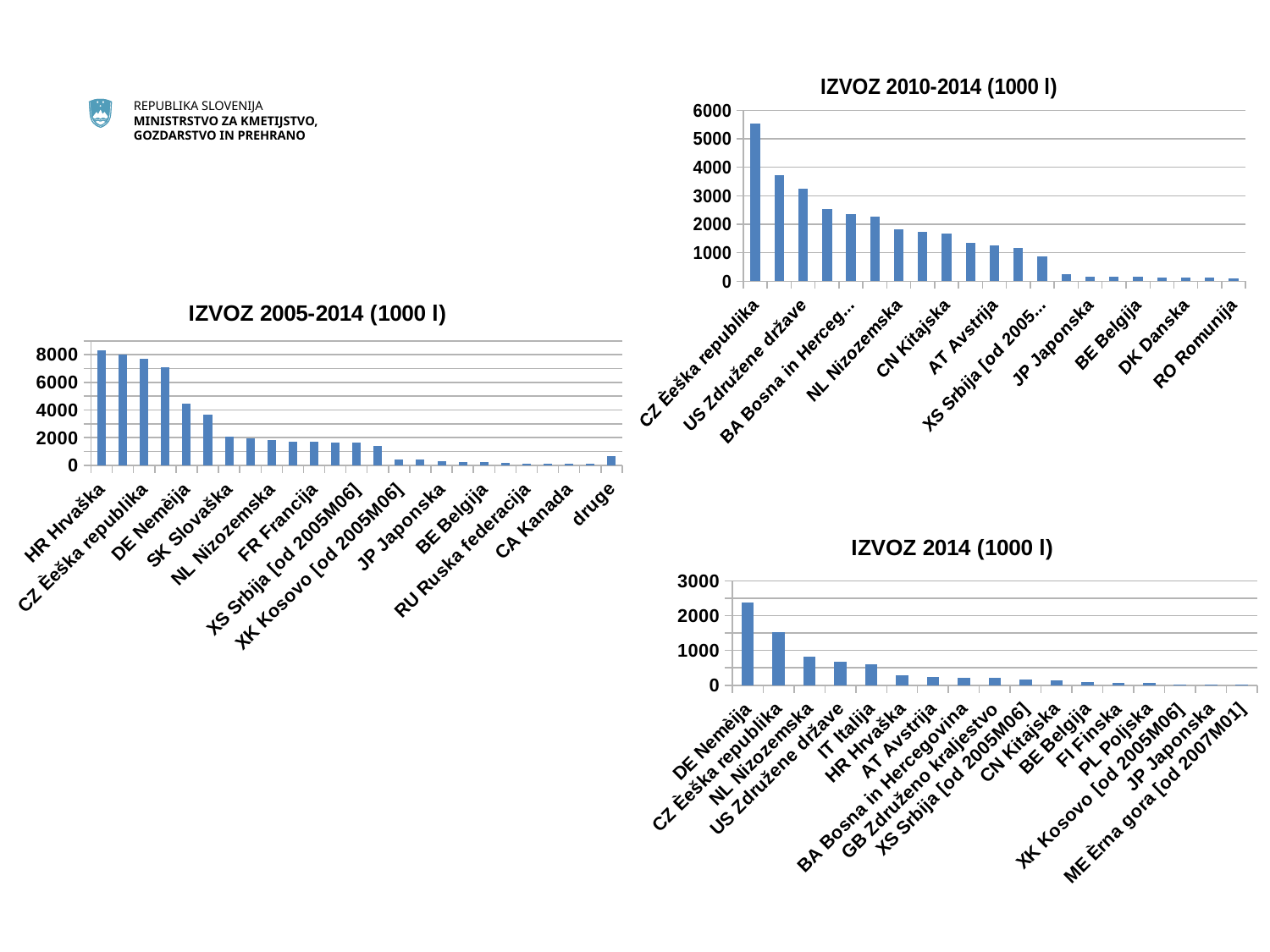
What is the title of the chart in the bottom right of the slide? IZVOZ 2014 (1000 l) In the 'IZVOZ 2014 (1000 l)' chart, which is larger, the value for DE Nemčija or CZ Češka republika? DE Nemčija In the 'IZVOZ 2005-2014 (1000 l)' chart, is the value for HR Hrvaška greater or less than 6000? greater In the 'IZVOZ 2005-2014 (1000 l)' chart, is the value for JP Japonska greater or less than 2000? less In the 'IZVOZ 2014 (1000 l)' chart, is the value for DE Nemčija greater or less than 2000? greater What kind of chart is the 'IZVOZ 2014 (1000 l)' chart? bar chart In the 'IZVOZ 2010-2014 (1000 l)' chart, which category has the highest value? CZ Češka republika In the 'IZVOZ 2014 (1000 l)' chart, which category has the highest value? DE Nemčija In the 'IZVOZ 2010-2014 (1000 l)' chart, do the values generally rise or fall from left to right along the x axis? fall In the 'IZVOZ 2005-2014 (1000 l)' chart, which category has the highest value? HR Hrvaška